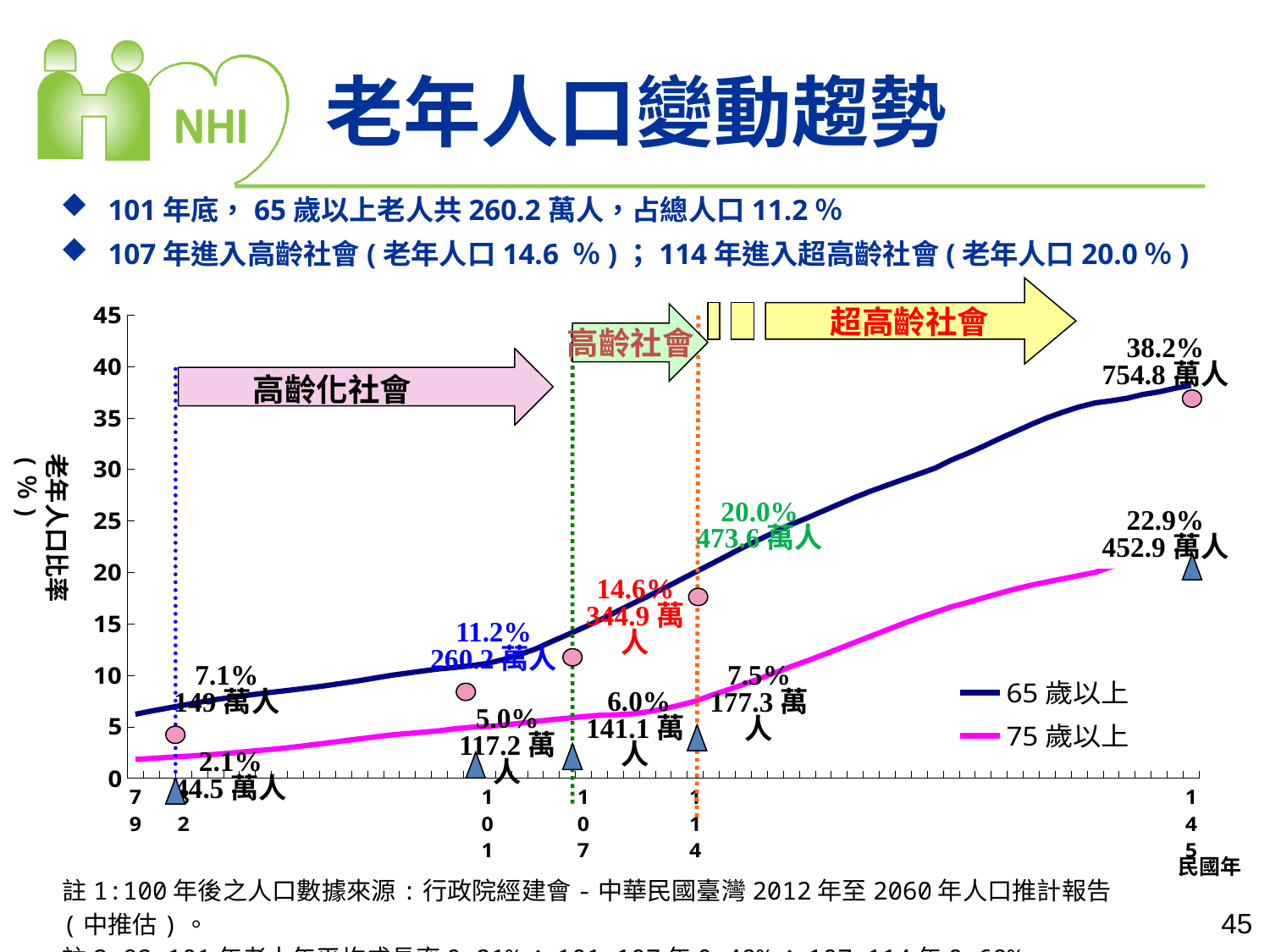
What percentage is labelled for the 65歲以上 series in year 107? 14.6% Is the 65歲以上 value in year 145 greater or less than 35? greater How many 萬人 are labelled for the 65歲以上 series in year 145? 754.8 萬人 What percentage is labelled for the 75歲以上 series in year 114? 7.5% Does the 65歲以上 line rise or fall from year 79 to year 145? rise What percentage is labelled for the 65歲以上 series in year 101? 11.2% What kind of chart is shown on the slide? line chart How many series does the legend list? 2 Which series has the higher value in year 114, 65歲以上 or 75歲以上? 65歲以上 What is the label of the y axis? 老年人口比率(%) How many 萬人 are labelled for the 75歲以上 series in year 82? 44.5 萬人 What is the difference between the 65歲以上 percentage and the 75歲以上 percentage in year 145? 15.3%